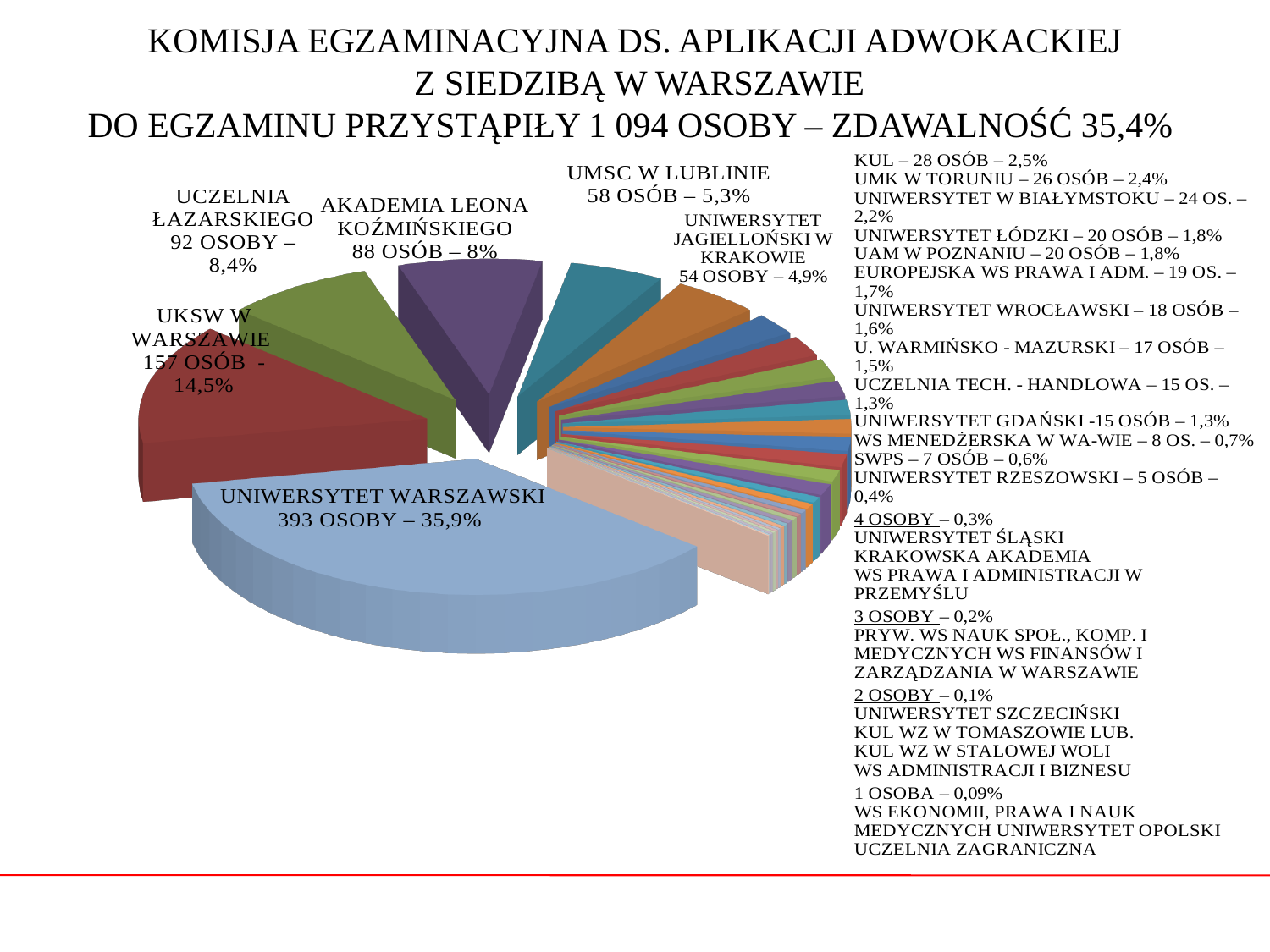
How many people from Uniwersytet Warszawski took the exam according to the chart? 393 How many people are listed for KUL in the chart annotations? 28 What percentage is shown for Akademia Leona Koźmińskiego? 8% What is the difference in the number of people between Uniwersytet Warszawski and UKSW w Warszawie? 236 Which has more people, UKSW w Warszawie or Uczelnia Łazarskiego? UKSW w Warszawie According to the slide title, how many people took the exam in total? 1 094 How many people are shown for UMSC w Lublinie? 58 What share of the pie does Uniwersytet Warszawski represent? 35,9% Which institution has the largest slice of the pie? Uniwersytet Warszawski What kind of chart is shown on the slide? pie chart How many people from UKSW w Warszawie are shown on the chart? 157 What percentage is shown for Uniwersytet Jagielloński w Krakowie? 4,9%